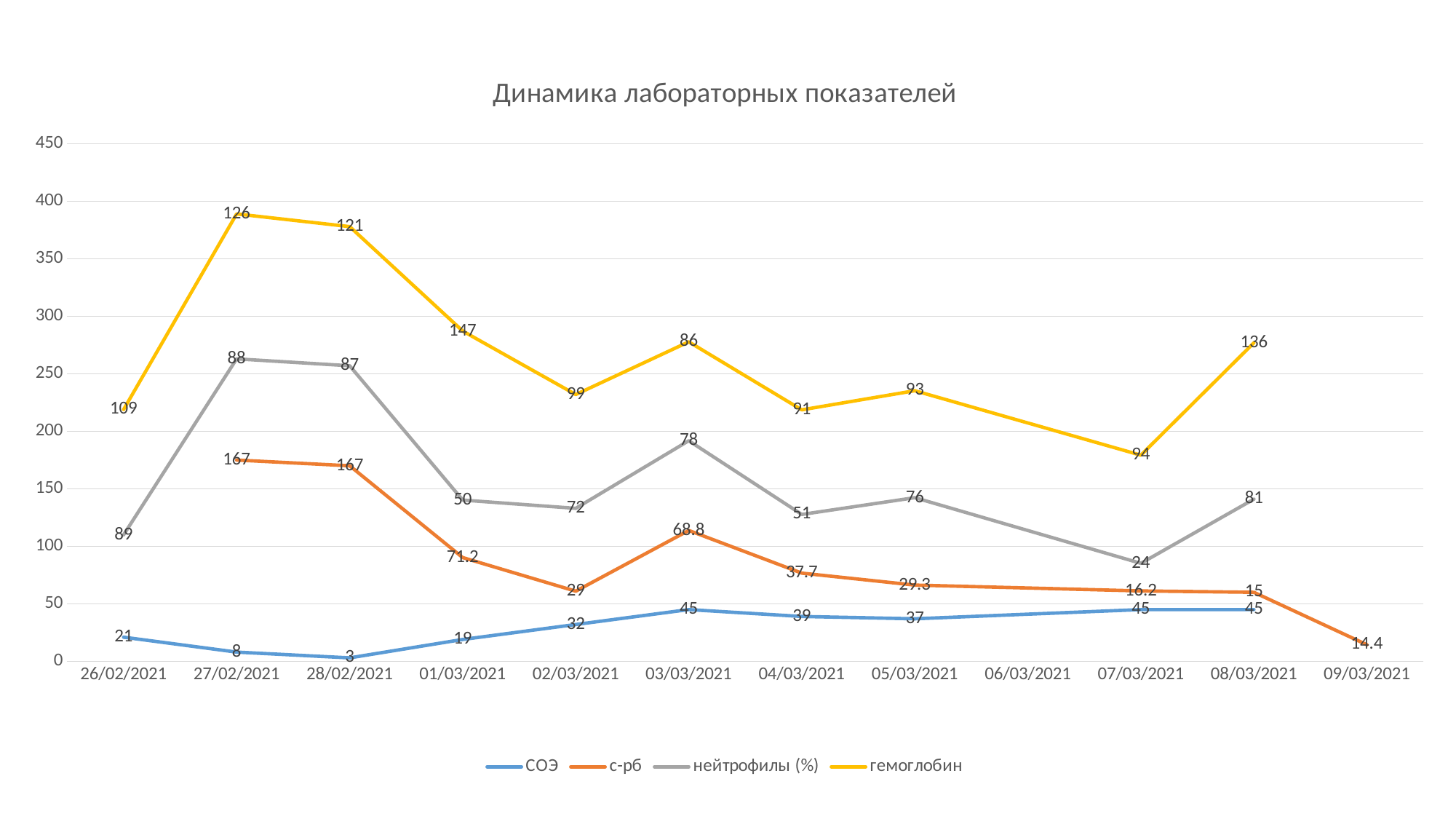
On which date is СОЭ at its lowest? 28/02/2021 What is the value of гемоглобин on 01/03/2021? 147 On which date is нейтрофилы (%) at its lowest? 07/03/2021 What kind of chart is shown on the slide? Line chart What is the value of с-рб on 09/03/2021? 14.4 On which date is гемоглобин at its highest? 01/03/2021 Which date has the higher нейтрофилы (%) value, 03/03/2021 or 04/03/2021? 03/03/2021 What is the difference between the гемоглобин values on 27/02/2021 and 26/02/2021? 17 Does the с-рб value rise or fall from 03/03/2021 to 09/03/2021? Fall What is the value of нейтрофилы (%) on 07/03/2021? 24 How many series does the legend list? 4 What is the value of СОЭ on 02/03/2021? 32